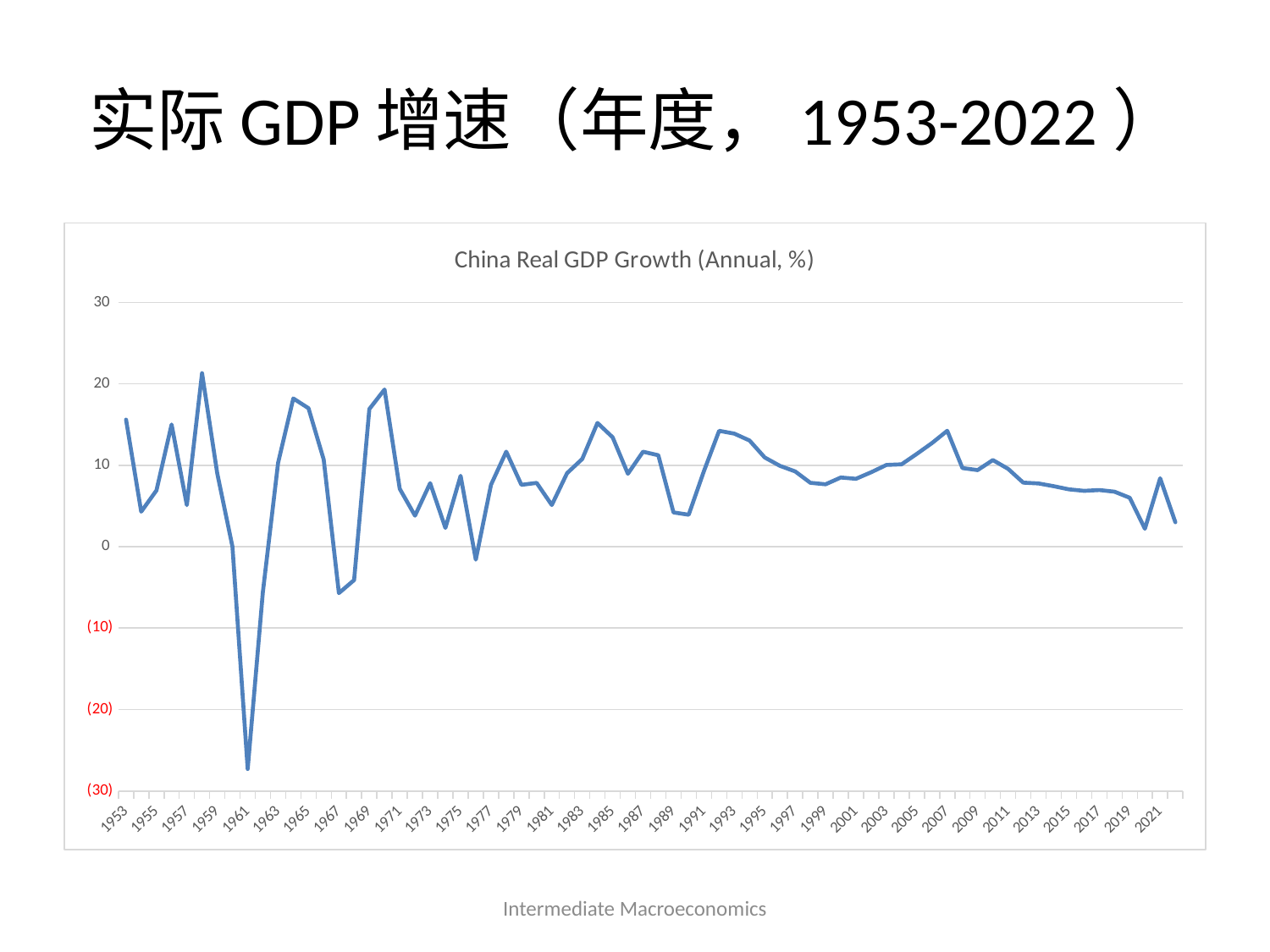
Is the value for 1967 greater or less than 0? less Is the value for 2007 greater or less than 10? greater What is the title printed inside the chart area? China Real GDP Growth (Annual, %) Which year has the higher real GDP growth, 2007 or 2020? 2007 In which year does China's real GDP growth reach its lowest point? 1961 What kind of chart is shown on the slide? line chart Is the value for 1990 greater or less than 10? less How many data series (lines) are plotted on the chart? 1 In which year does China's real GDP growth reach its highest point? 1958 Does China's real GDP growth generally rise or fall from 2007 to 2020? fall